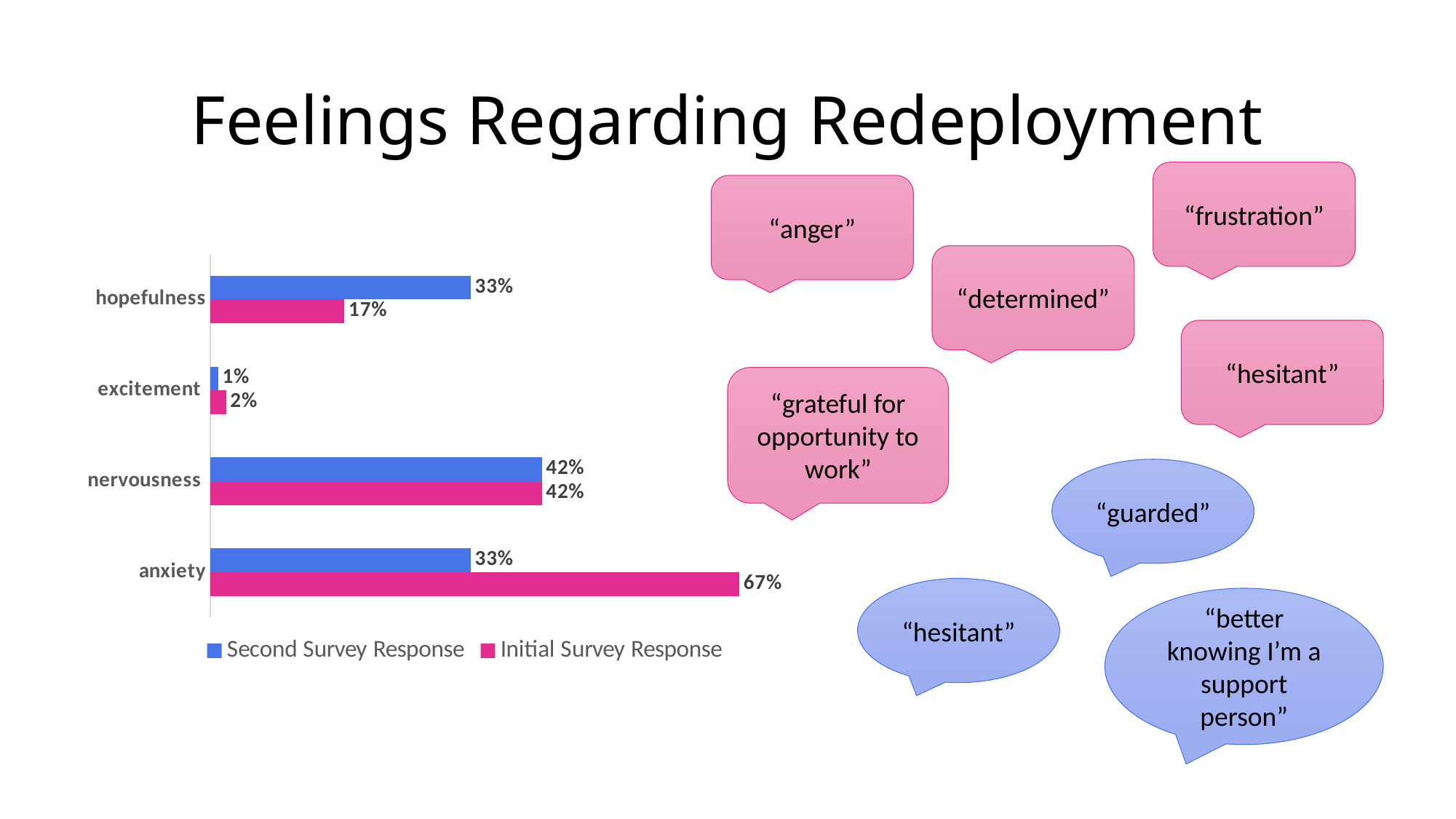
How many feeling categories are shown in the chart? 4 How many series does the chart legend list? 2 What kind of chart is shown on the slide? bar chart What is the Second Survey Response value for nervousness? 42% What is the Second Survey Response value for hopefulness? 33% Which category has the lowest Second Survey Response value? excitement Which is larger for hopefulness: the Second Survey Response or the Initial Survey Response? Second Survey Response Which category has the highest Initial Survey Response value? anxiety What is the Initial Survey Response value for anxiety? 67% What is the Initial Survey Response value for excitement? 2% What is the difference between the Initial Survey Response and Second Survey Response values for anxiety? 34% Which colour represents the Initial Survey Response series? pink